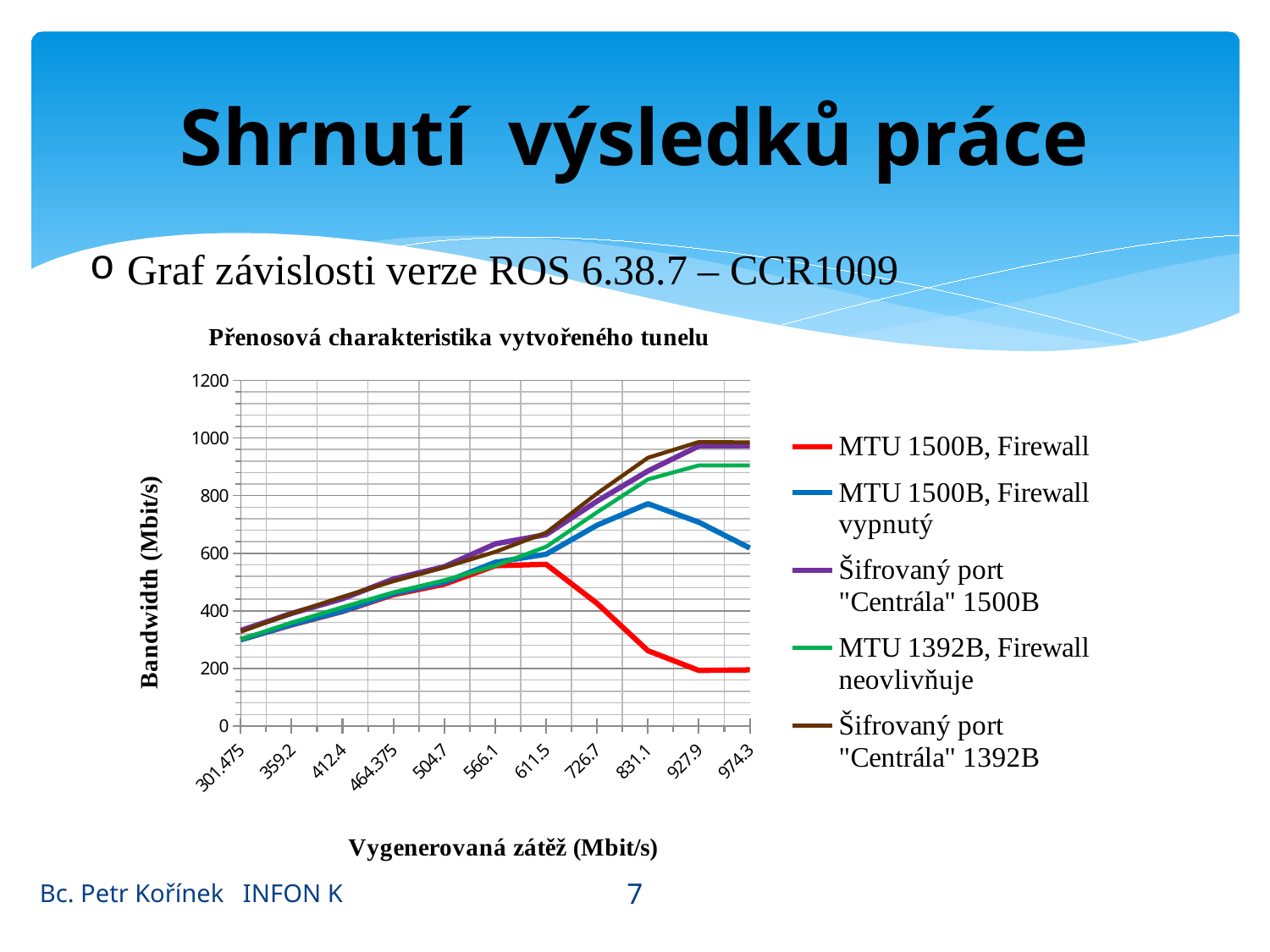
What is the title of the chart? Přenosová charakteristika vytvořeného tunelu Which series has the lowest value at 974.3? MTU 1500B, Firewall What is the label of the y axis? Bandwidth (Mbit/s) What type of chart is shown on the slide? line chart Is the value for "MTU 1392B, Firewall neovlivňuje" at 974.3 greater or less than 800? greater Is the value for "Šifrovaný port "Centrála" 1392B" at 927.9 greater or less than 800? greater Is the value for "MTU 1500B, Firewall" at 831.1 greater or less than 400? less How many points are labelled along the x axis of the chart? 11 Does the "Šifrovaný port "Centrála" 1392B" series rise or fall from 301.475 to 974.3? rise At 974.3, which is larger: "MTU 1500B, Firewall vypnutý" or "MTU 1392B, Firewall neovlivňuje"? MTU 1392B, Firewall neovlivňuje How many series does the chart legend list? 5